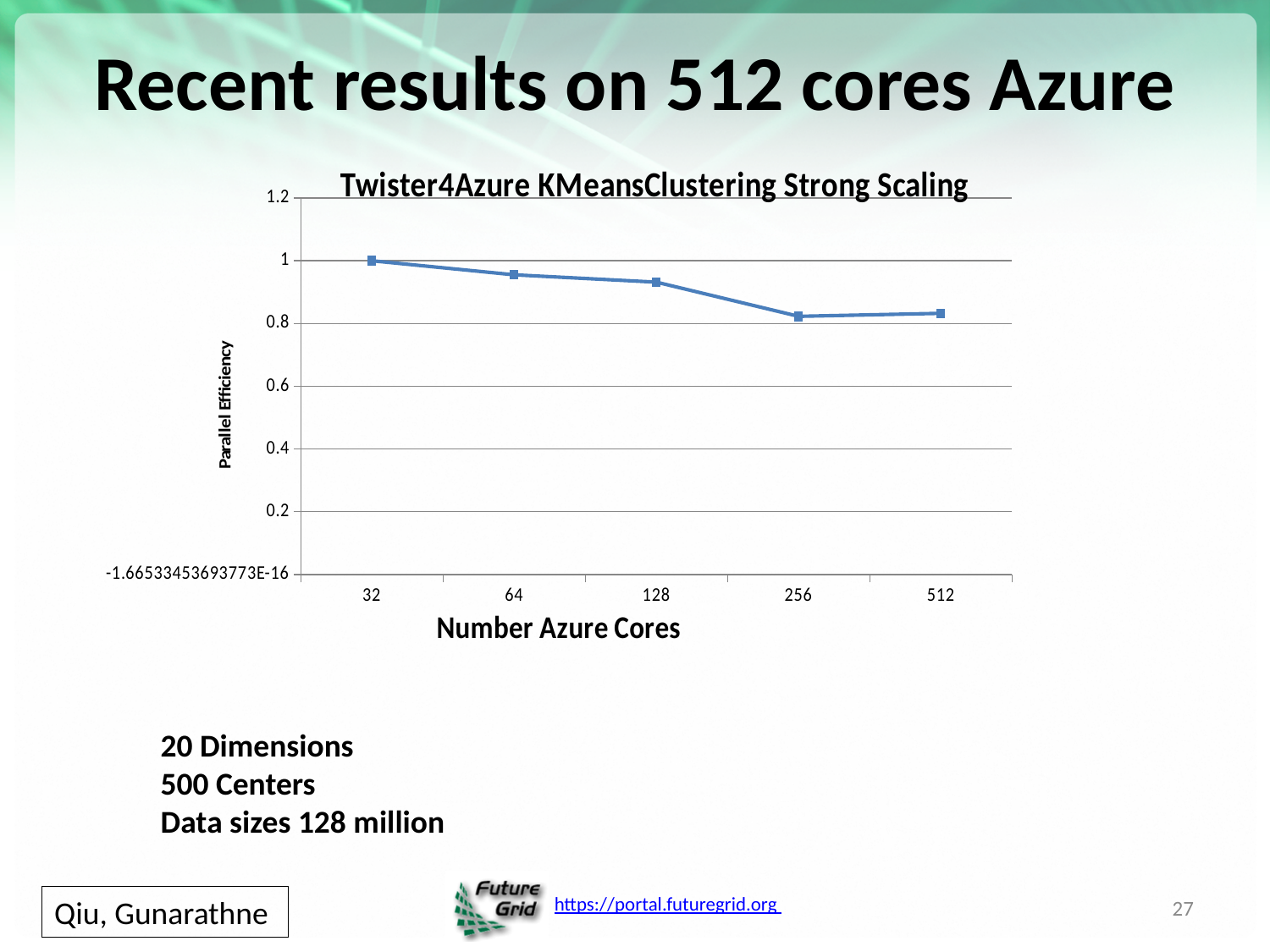
At which number of Azure cores is the parallel efficiency highest? 32 What is the parallel efficiency at 32 Azure cores? 1 How many data points are plotted on the chart? 5 Is the parallel efficiency at 64 cores greater or less than 1? less What kind of chart is shown on the slide? line chart What is the title of the chart? Twister4Azure KMeansClustering Strong Scaling Is the parallel efficiency at 128 cores greater or less than 0.8? greater Does the parallel efficiency generally rise or fall as the number of Azure cores increases? fall Is the parallel efficiency at 512 cores greater or less than 0.6? greater Which has a higher parallel efficiency, 64 cores or 256 cores? 64 cores What is the label of the x axis of the chart? Number Azure Cores Which has a higher parallel efficiency, 128 cores or 512 cores? 128 cores